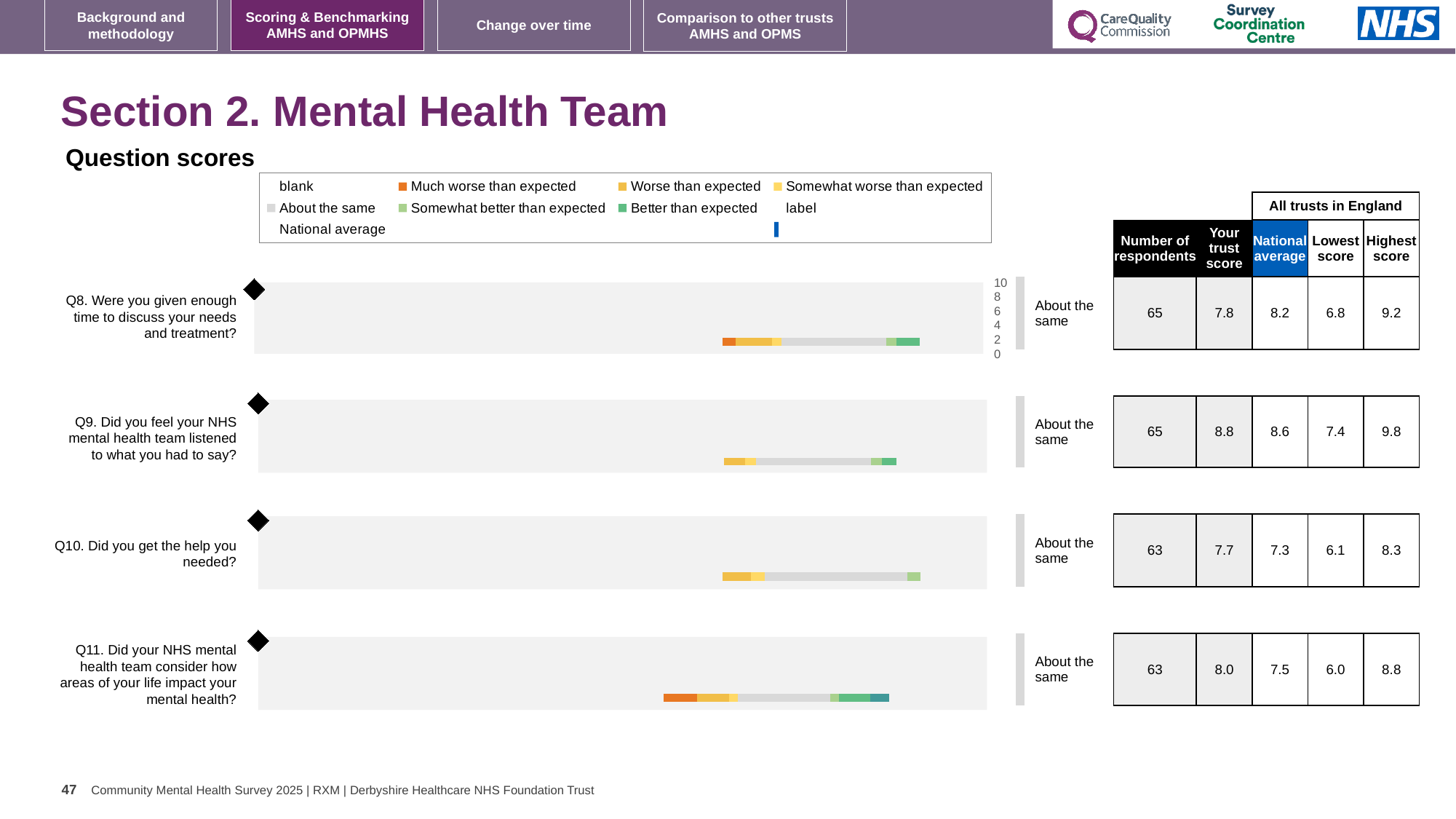
What kind of chart is used for each question score on the slide? bar chart In the table, what is the highest score across all trusts in England for Q11? 8.8 In the table, what is the national average for Q10? 7.3 How many questions are charted on the slide (Q8 to Q11)? 4 In the legend, what colour represents 'Much worse than expected'? orange What is the highest tick shown on the score axis next to the Q8 chart? 10 Which question has the highest 'Your trust score' in the table? Q9 In the table, how many respondents are listed for Q8? 65 Which question has the lowest 'Your trust score' in the table? Q10 For Q11, which is larger: the trust score or the national average? the trust score In the table, what is the trust score for Q9? 8.8 For Q8, what is the difference between the national average and the trust score? 0.4